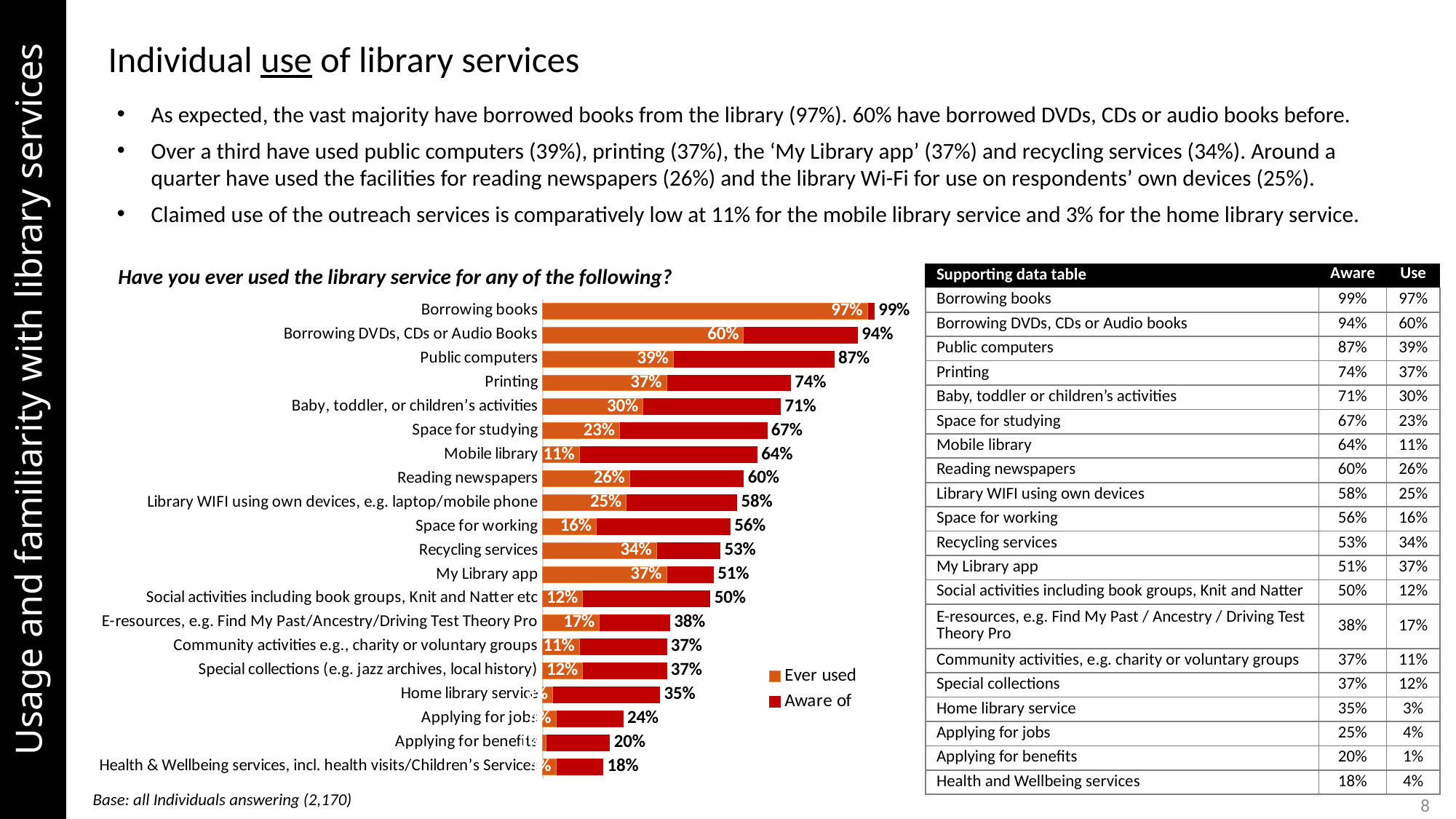
What kind of chart is shown on the slide? Bar chart What is the 'Ever used' value for Public computers? 39% How many series does the chart legend list? 2 What is the 'Ever used' value for Mobile library? 11% Is the 'Ever used' value for Home library service greater or less than 20%? less How many services are listed in the chart? 20 What are the two legend entries of the chart? Ever used and Aware of What is the 'Aware of' value for Printing? 74% Which service has the lowest 'Aware of' value? Health & Wellbeing services, incl. health visits/Children's Services For Borrowing DVDs, CDs or Audio Books, what is the difference between the 'Aware of' value and the 'Ever used' value? 34 percentage points Which service has the highest 'Aware of' value? Borrowing books Which has a higher 'Ever used' value: Recycling services or Space for studying? Recycling services